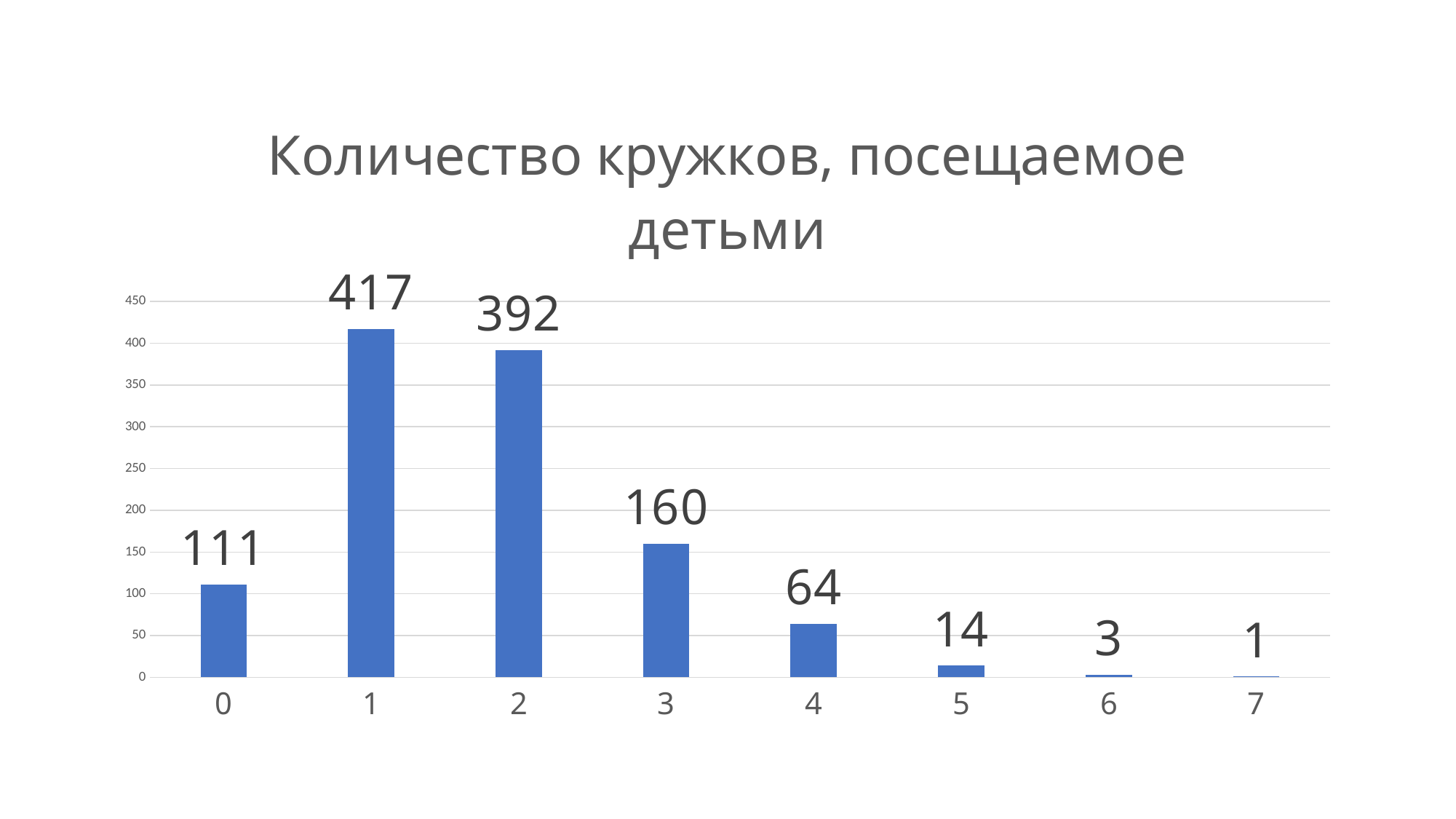
What is the value for category 0? 111 What kind of chart is shown on the slide? bar chart How many categories are shown on the x axis? 8 What is the value for category 1? 417 Which is larger, the value for category 0 or the value for category 3? 3 Which category has the highest value? 1 What is the difference between the values for categories 3 and 4? 96 What is the difference between the values for categories 1 and 2? 25 What is the title of the chart? Количество кружков, посещаемое детьми Which category has the lowest value? 7 What is the value for category 4? 64 Is the value for category 2 greater or less than 350? greater